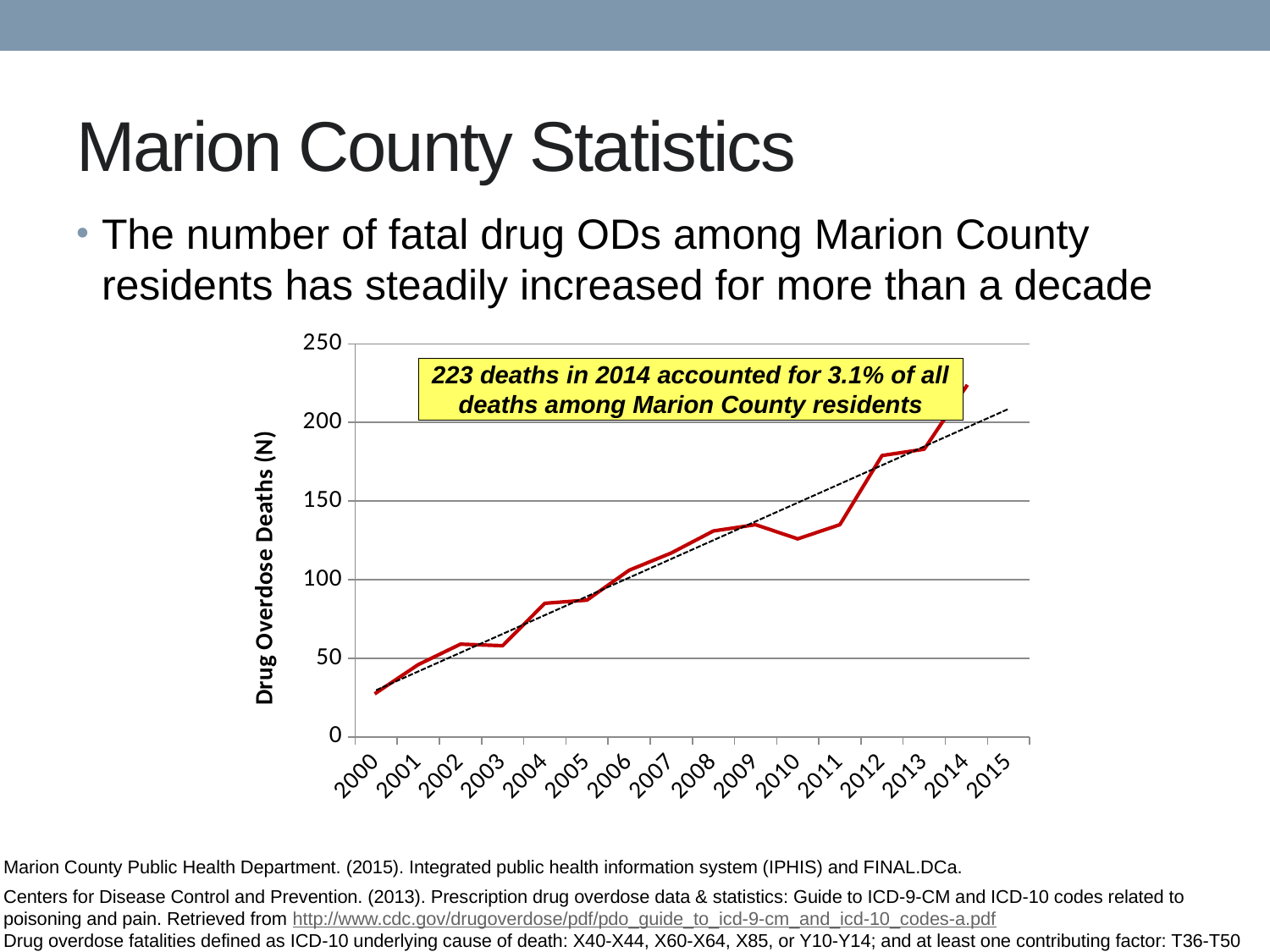
According to the annotation on the chart, how many drug overdose deaths were there in 2014? 223 Is the value for 2004 greater or less than 100? less What is the title of the y axis? Drug Overdose Deaths (N) According to the annotation, what percentage of all deaths among Marion County residents in 2014 were drug overdose deaths? 3.1% Which year has more drug overdose deaths, 2010 or 2012? 2012 Which year has the highest number of drug overdose deaths? 2014 Do the drug overdose deaths generally rise or fall from 2000 to 2014? rise Is the value for 2012 greater or less than 150? greater Which year has the lowest number of drug overdose deaths? 2000 What kind of chart is shown on the slide? line chart Is the value for 2010 greater or less than 150? less